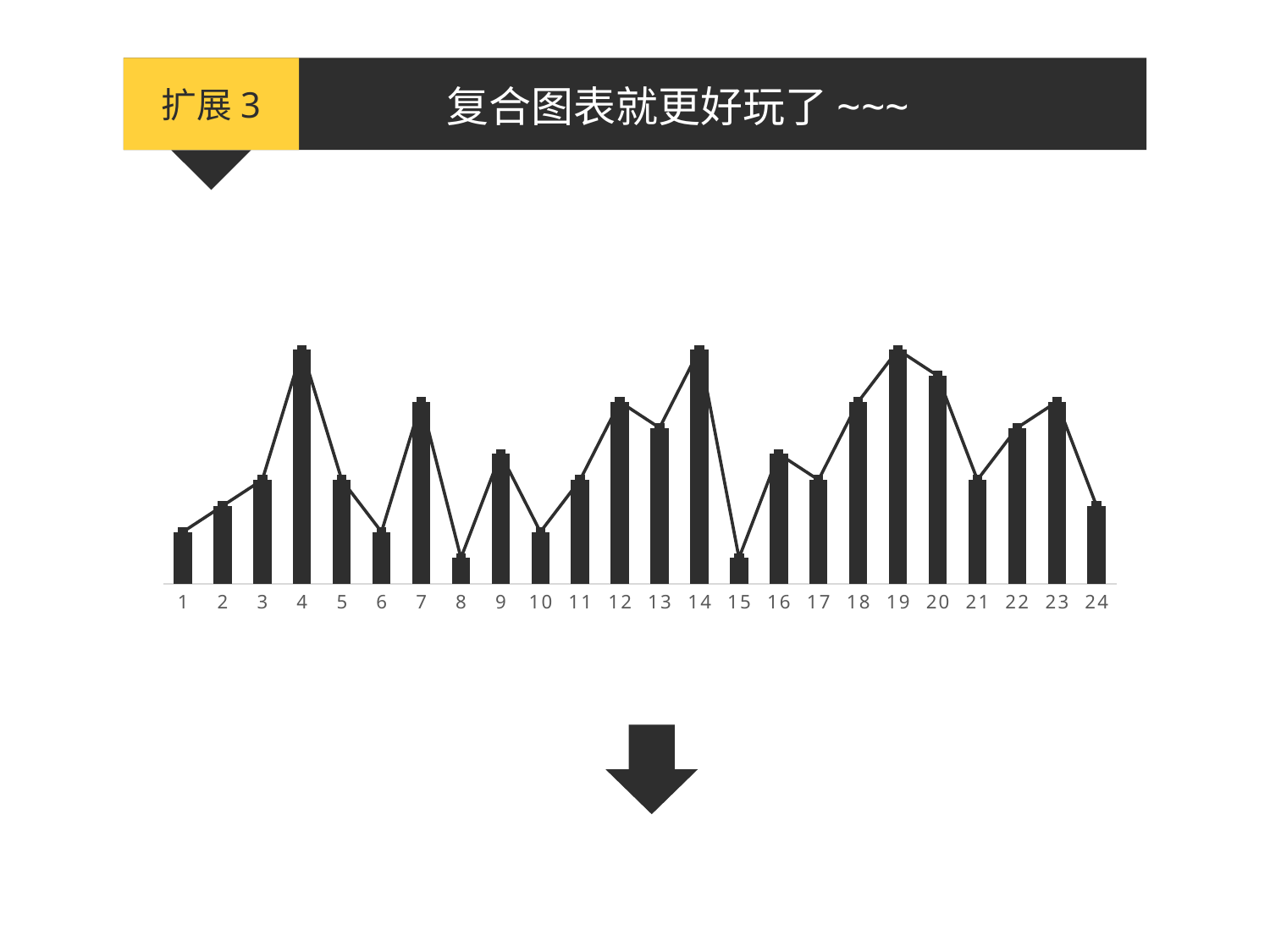
Which is larger, the bar for category 4 or the bar for category 6? 4 What label appears in the yellow box at the top left of the slide? 扩展 3 Do the values rise or fall from category 15 to category 19? rise Which is larger, the bar for category 8 or the bar for category 9? 9 Do the values rise or fall from category 4 to category 6? fall How many categories are shown on the x axis of the chart? 24 Do the values rise or fall from category 1 to category 4? rise Which is larger, the bar for category 15 or the bar for category 16? 16 What kind of chart is shown on the slide? A combination chart of bars with a line overlaid What is the title text shown in the dark header bar above the chart? 复合图表就更好玩了 ~~~